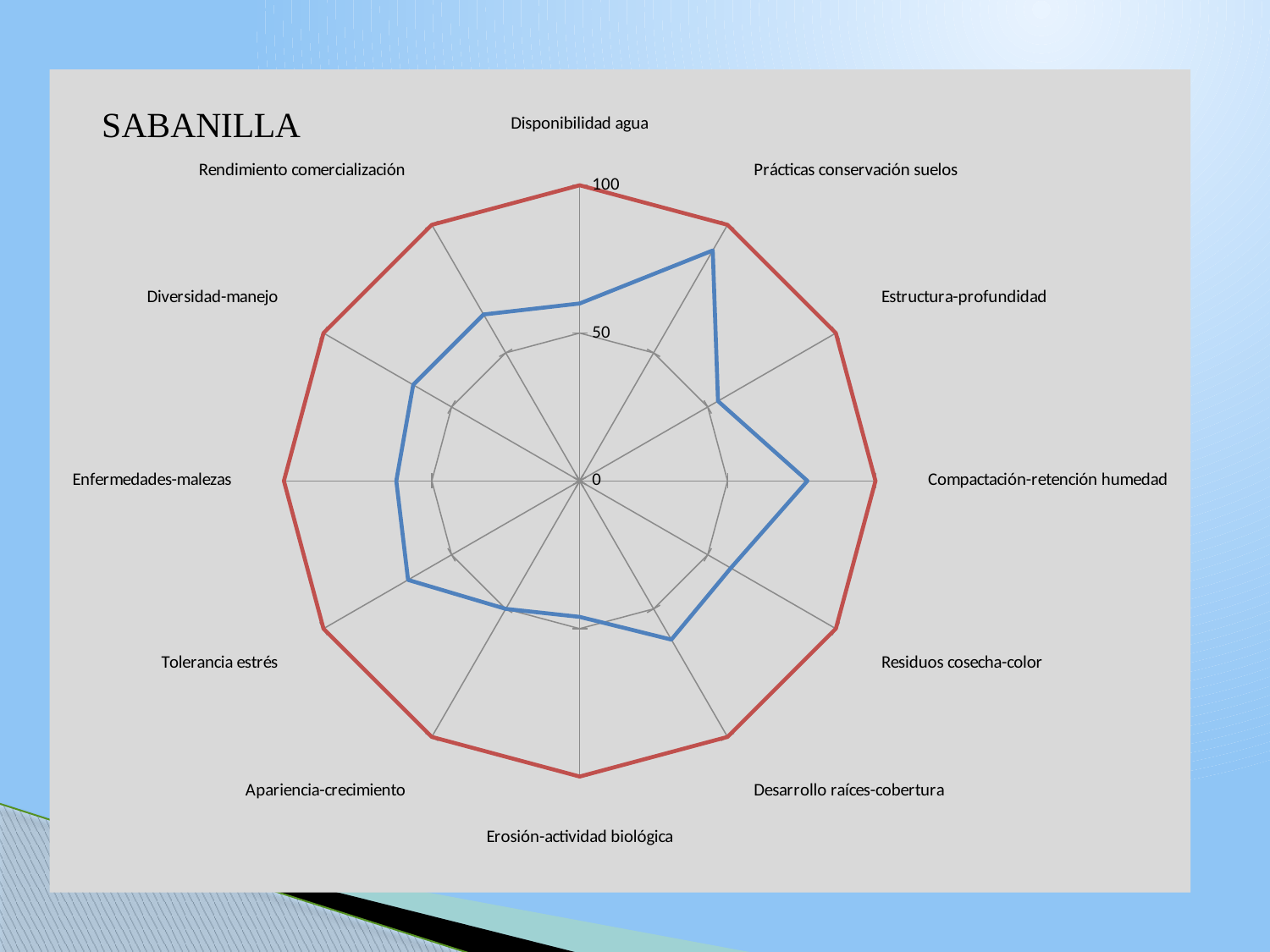
Is the blue series value for Compactación-retención humedad greater or less than 50? greater In the blue series, which is larger: the value for Prácticas conservación suelos or the value for Estructura-profundidad? Prácticas conservación suelos Is the blue series value for Prácticas conservación suelos greater or less than 50? greater Is the blue series value for Tolerancia estrés greater or less than 100? less What is the title of the chart? SABANILLA For which category does the blue series reach its highest value? Prácticas conservación suelos What is the maximum value shown on the radial axis? 100 What value does the red series reach for Disponibilidad agua? 100 What kind of chart is shown on the slide? Radar chart How many categories (axes) does the radar chart have? 12 How many data series are plotted on the radar chart? 2 What value does the red series reach for Compactación-retención humedad? 100